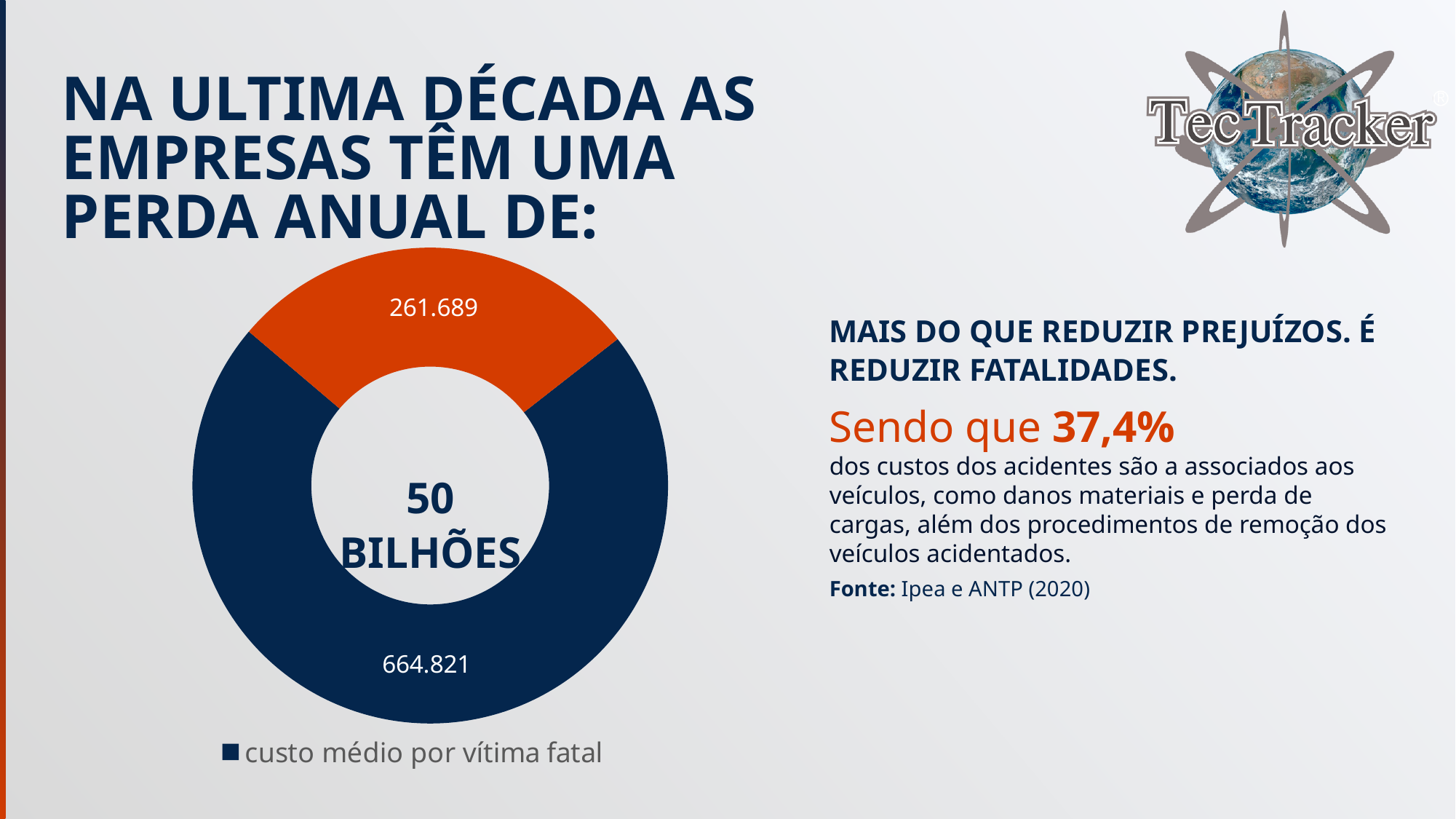
Is the dark blue slice's value larger or smaller than the orange slice's value? Larger What value is shown on the dark blue slice of the doughnut chart? 664.821 Which slice of the doughnut chart has the largest value? The dark blue slice (664.821) How many slices does the doughnut chart have? 2 What value is shown on the orange slice of the doughnut chart? 261.689 How many entries does the chart legend list? 1 What text is displayed in the centre of the doughnut chart? 50 BILHÕES Which slice of the doughnut chart has the smallest value? The orange slice (261.689) What kind of chart is shown on the slide? Doughnut (pie) chart What is the difference between the dark blue slice value (664.821) and the orange slice value (261.689)? 403.132 What is the legend entry text below the doughnut chart? custo médio por vítima fatal What is the total of the two values shown on the doughnut chart? 926.510